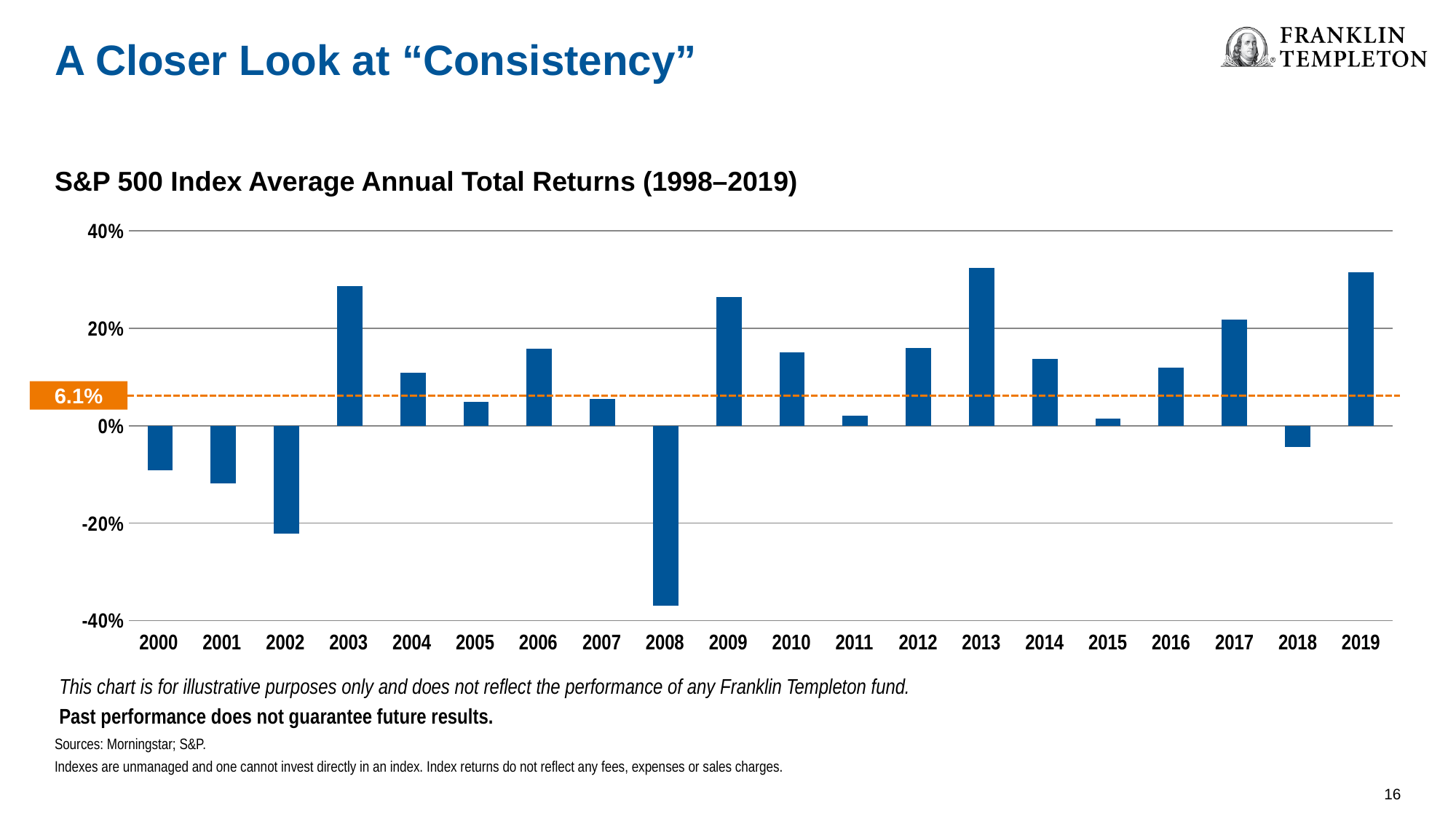
How many years are plotted on the x axis of the chart? 20 What kind of chart is shown on the slide? bar chart Which year has the larger return, 2005 or 2006? 2006 Is the value for 2003 greater or less than 20%? greater Which year has the larger return, 2003 or 2004? 2003 Which year has the lowest S&P 500 annual total return in the chart? 2008 Is the value for 2008 greater or less than -20%? less How many years in the chart show a negative return? 5 Is the value for 2009 greater or less than 20%? greater What is the title of the chart? S&P 500 Index Average Annual Total Returns (1998–2019) What value is marked by the orange dashed horizontal line on the chart? 6.1%